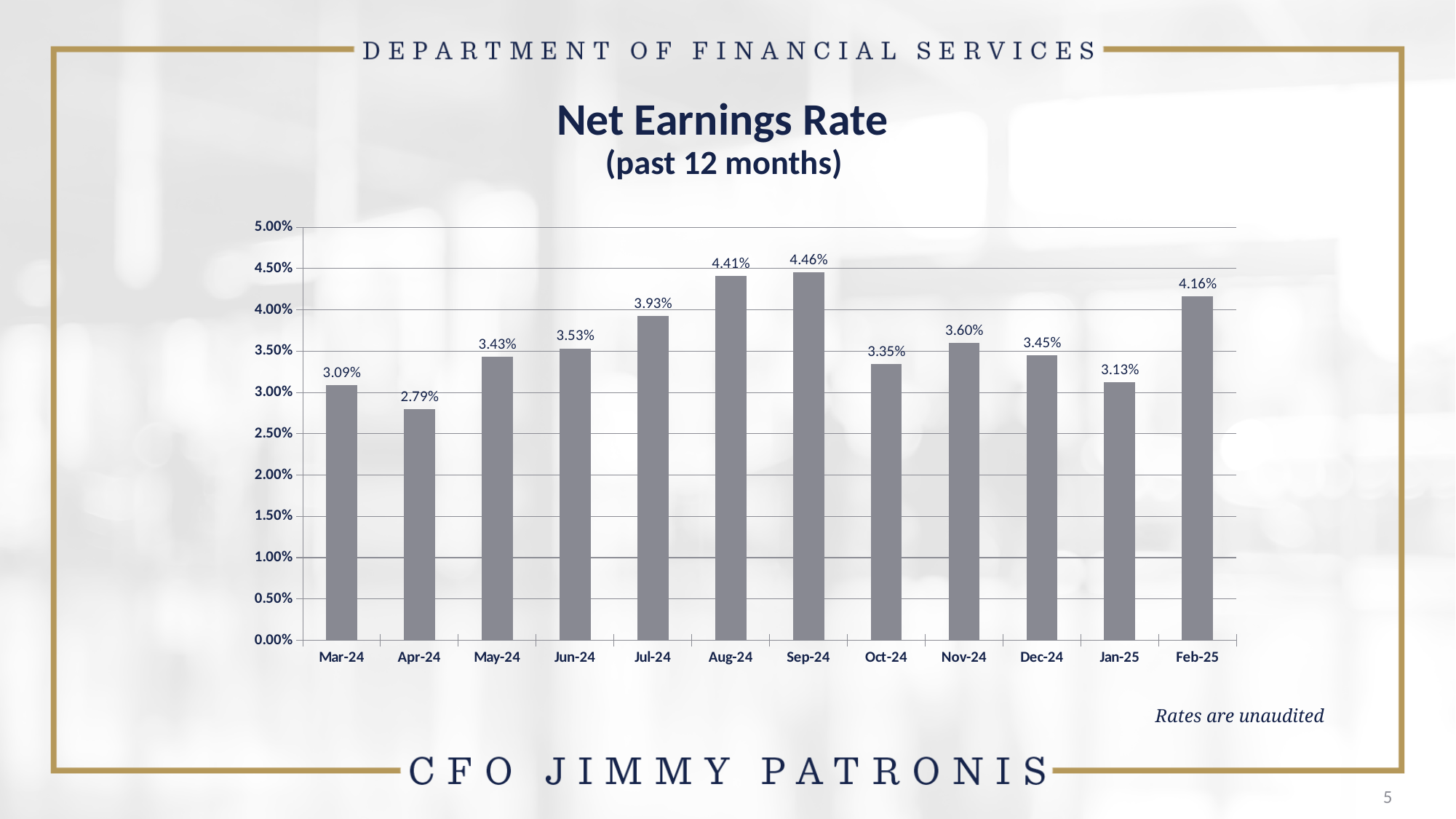
How many months are shown on the chart? 12 What is the net earnings rate for Sep-24? 4.46% Which month has the lowest net earnings rate? Apr-24 What is the difference between the net earnings rate in Sep-24 and Apr-24? 1.67% Is the value for Jul-24 greater or less than 3.50%? greater Which month has the highest net earnings rate? Sep-24 What kind of chart is shown on the slide? Bar chart What is the net earnings rate for Apr-24? 2.79% What is the title of the chart? Net Earnings Rate (past 12 months) Does the net earnings rate rise or fall from Sep-24 to Oct-24? Fall What is the net earnings rate for Feb-25? 4.16% Which is larger, the net earnings rate for Nov-24 or Dec-24? Nov-24